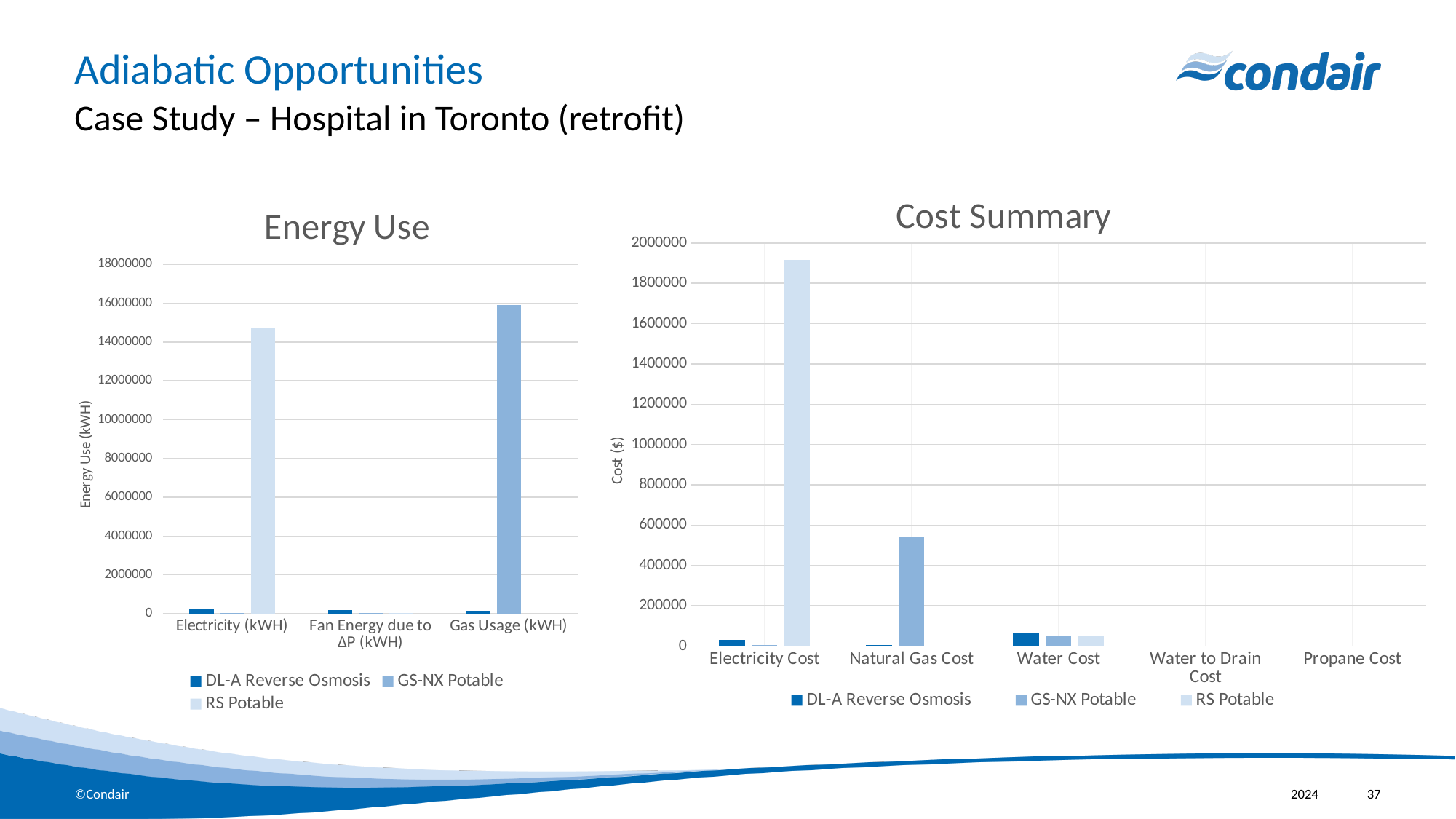
How many categories are shown on the x axis of the Cost Summary chart? 5 In the Energy Use chart, which is larger: the RS Potable bar for Electricity (kWH) or the GS-NX Potable bar for Gas Usage (kWH)? GS-NX Potable bar for Gas Usage (kWH) How many series does the legend of the Cost Summary chart list? 3 What is the y-axis title of the Energy Use chart? Energy Use (kWH) In the Cost Summary chart, is the RS Potable value for Electricity Cost greater or less than 1800000? greater How many categories are shown on the x axis of the Energy Use chart? 3 In the Cost Summary chart, is the GS-NX Potable value for Natural Gas Cost greater or less than 600000? less In the Energy Use chart, is the RS Potable value for Electricity (kWH) greater or less than 14000000? greater In the Cost Summary chart, which category contains the tallest bar? Electricity Cost What kind of chart is the Energy Use chart? bar chart What is the y-axis title of the Cost Summary chart? Cost ($)